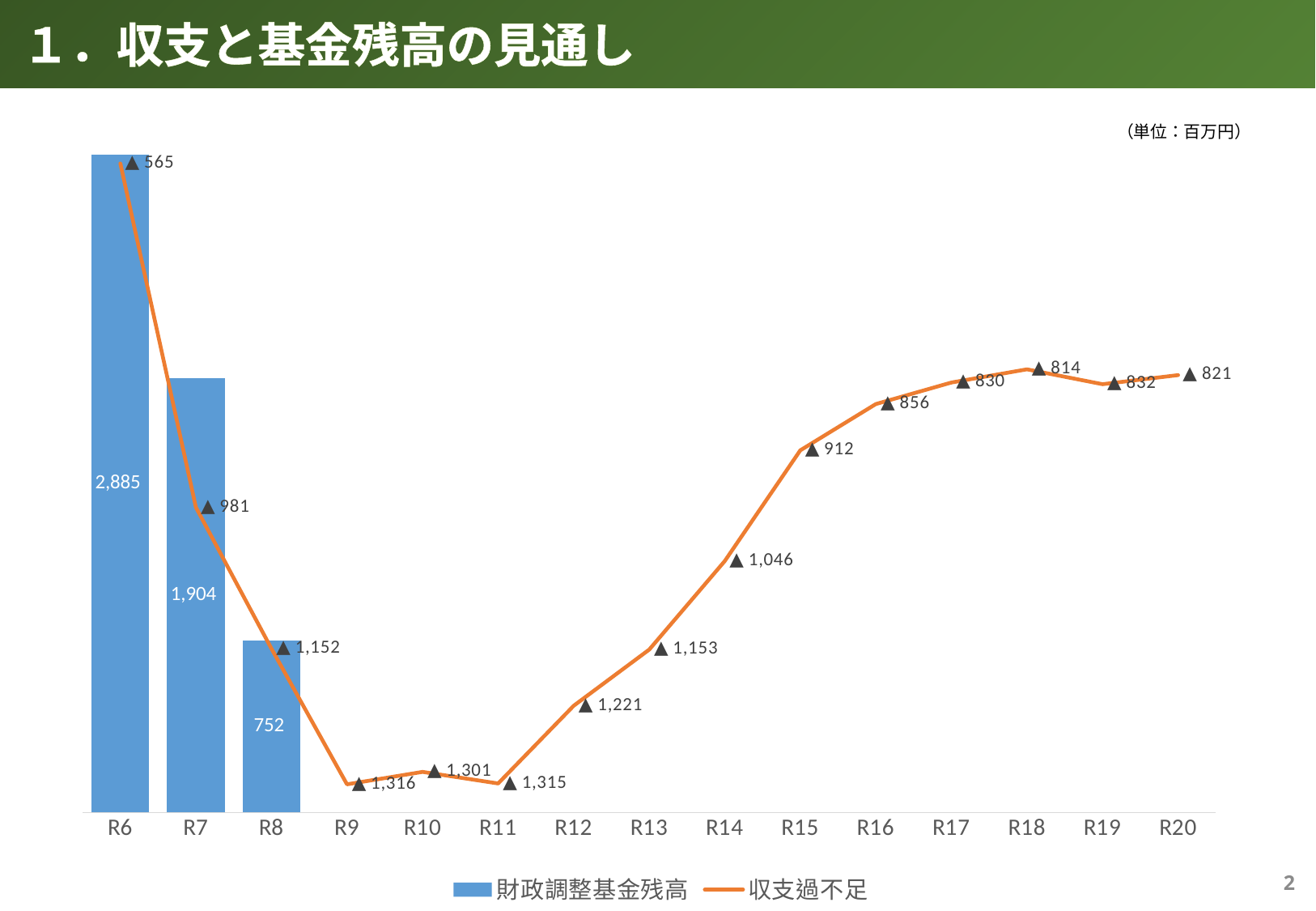
How many series does the legend list? 2 What is the difference between the 財政調整基金残高 values for R6 and R7? 981 How many years are shown on the x axis? 15 Which year has the lowest 財政調整基金残高 bar? R8 What is the value of 財政調整基金残高 for R8? 752 Which year has the highest 財政調整基金残高 bar? R6 What is the 収支過不足 value labelled for R9? ▲1,316 What kinds of chart are combined on this slide? Bar chart and line chart What is the 収支過不足 value labelled for R20? ▲821 What unit is stated for the values on the chart? 百万円 What is the value of 財政調整基金残高 for R6? 2,885 Which is larger, the 財政調整基金残高 bar for R7 or for R8? R7